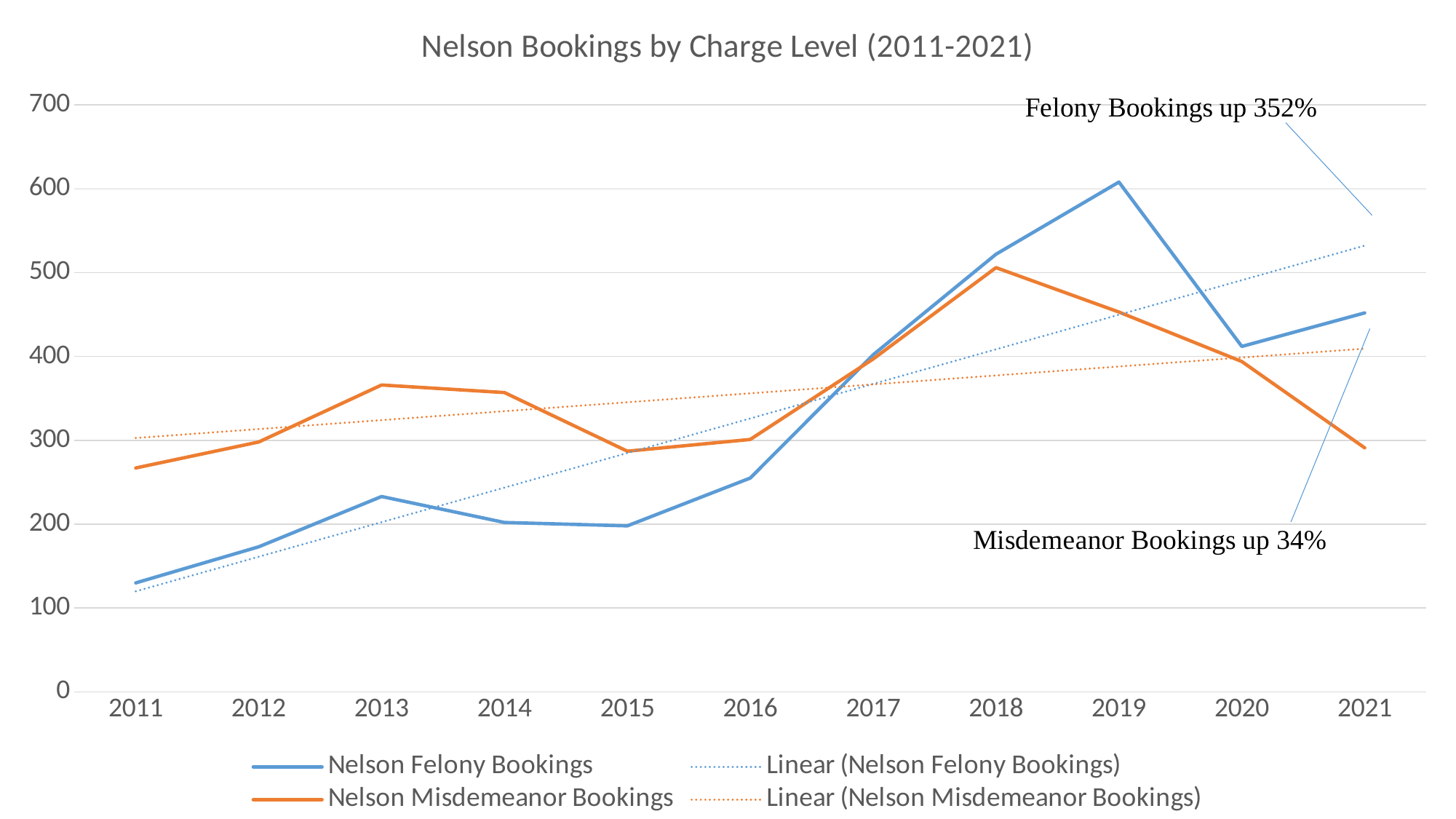
What type of chart is shown on the slide? line chart Is the value for Nelson Misdemeanor Bookings in 2013 greater or less than 300? greater In which year do Nelson Misdemeanor Bookings reach their highest value? 2018 How many years are plotted along the x axis? 11 In 2013, which series has the larger value: Nelson Felony Bookings or Nelson Misdemeanor Bookings? Nelson Misdemeanor Bookings In which year do Nelson Felony Bookings reach their highest value? 2019 Is the value for Nelson Felony Bookings in 2011 greater or less than 200? less According to the annotation on the chart, by what percentage are Felony Bookings up? 352% Is the value for Nelson Felony Bookings in 2019 greater or less than 500? greater In 2021, which series has the larger value: Nelson Felony Bookings or Nelson Misdemeanor Bookings? Nelson Felony Bookings In which year are Nelson Felony Bookings lowest? 2011 How many series does the legend list? 4